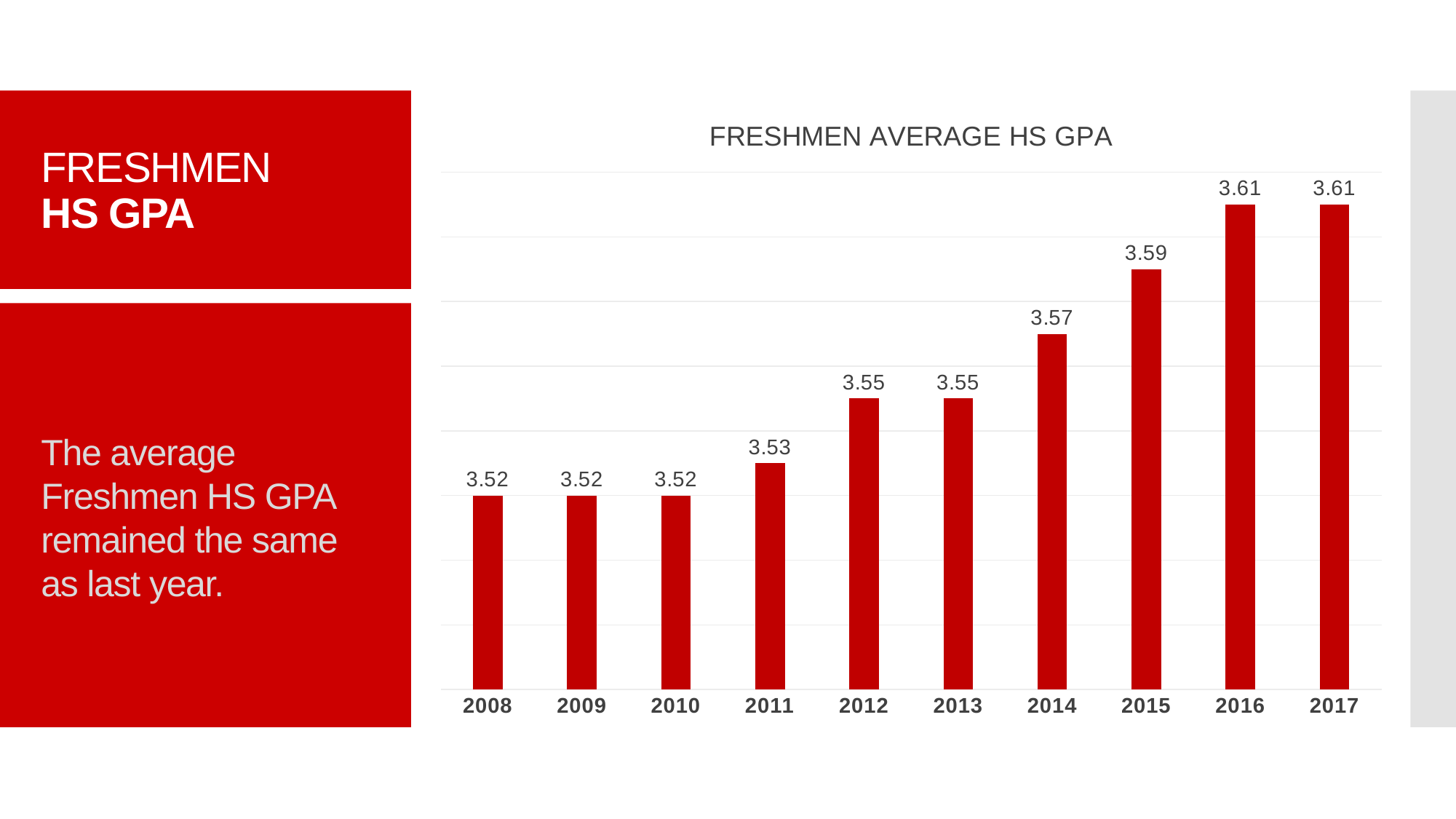
What is the freshmen average HS GPA for 2014? 3.57 Which year has the lowest freshmen average HS GPA shown, among 2011 through 2017? 2011 Which is larger, the freshmen average HS GPA in 2012 or in 2015? 2015 What kind of chart is shown on the slide? Bar chart What is the difference between the freshmen average HS GPA in 2015 and in 2013? 0.04 Do the freshmen average HS GPA values generally rise or fall from 2008 to 2017? Rise What is the freshmen average HS GPA for 2017? 3.61 What is the title of the chart? FRESHMEN AVERAGE HS GPA What colour are the bars in the chart? Red What is the freshmen average HS GPA for 2011? 3.53 What is the difference between the freshmen average HS GPA in 2017 and in 2008? 0.09 How many years are shown on the x axis of the chart? 10